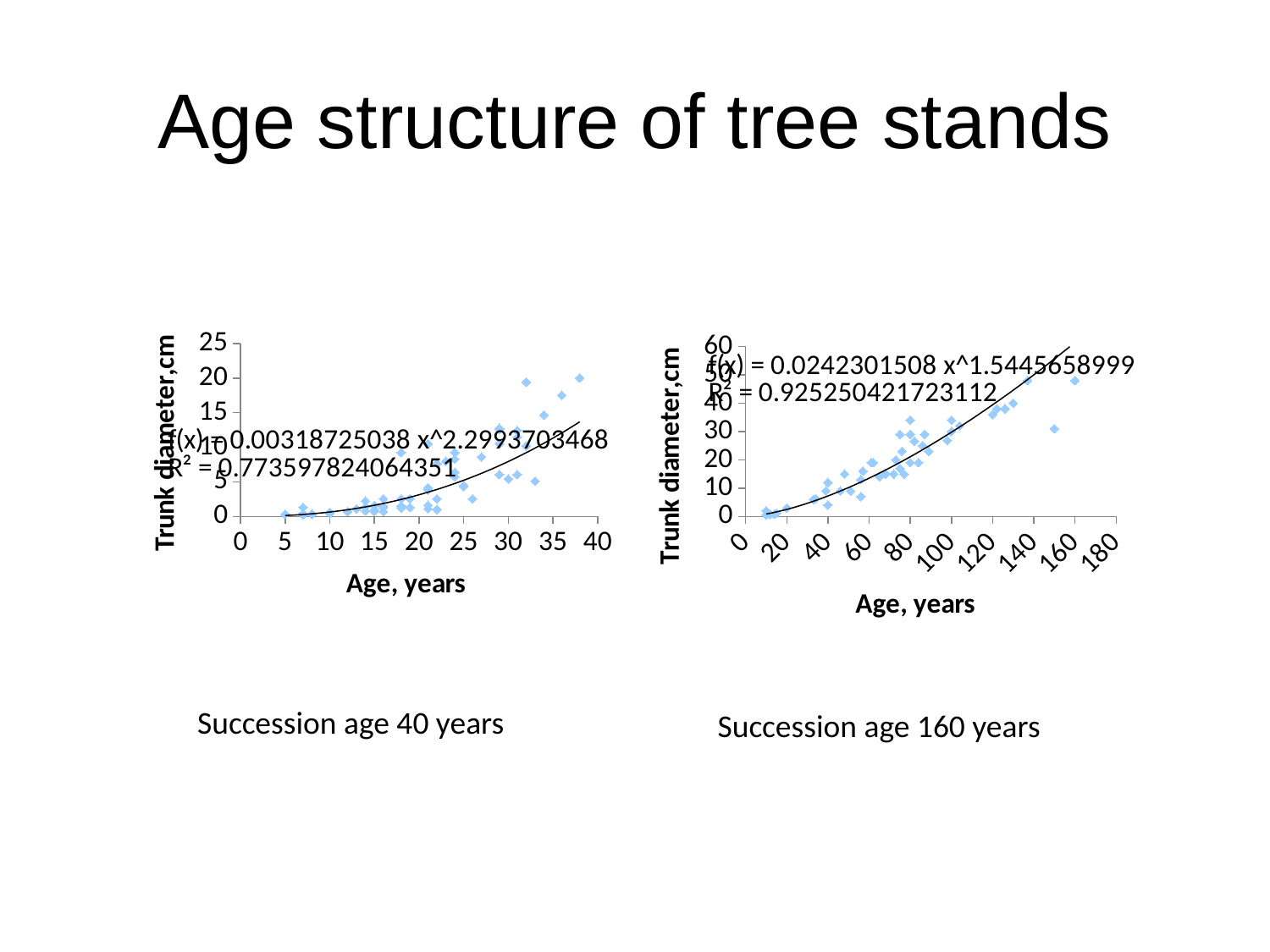
In the right chart (Succession age 160 years), are the trunk diameters for trees younger than 20 years greater or less than 10 cm? less In the left chart (Succession age 40 years), are the trunk diameters for trees younger than 10 years greater or less than 5 cm? less In the right chart (Succession age 160 years), is the highest plotted trunk diameter greater or less than 40? greater What is the maximum value shown on the x axis of the right chart (Succession age 160 years)? 180 What is the R² value printed on the right chart (Succession age 160 years)? 0.925250421723112 In the right chart (Succession age 160 years), does trunk diameter rise or fall as age increases? rise Which chart has the higher R² value, the left chart (Succession age 40 years) or the right chart (Succession age 160 years)? the right chart (Succession age 160 years) What kind of chart is the right chart (Succession age 160 years)? scatter chart What kind of chart is the left chart (Succession age 40 years)? scatter chart What is the R² value printed on the left chart (Succession age 40 years)? 0.773597824064351 In the left chart (Succession age 40 years), does trunk diameter rise or fall as age increases? rise